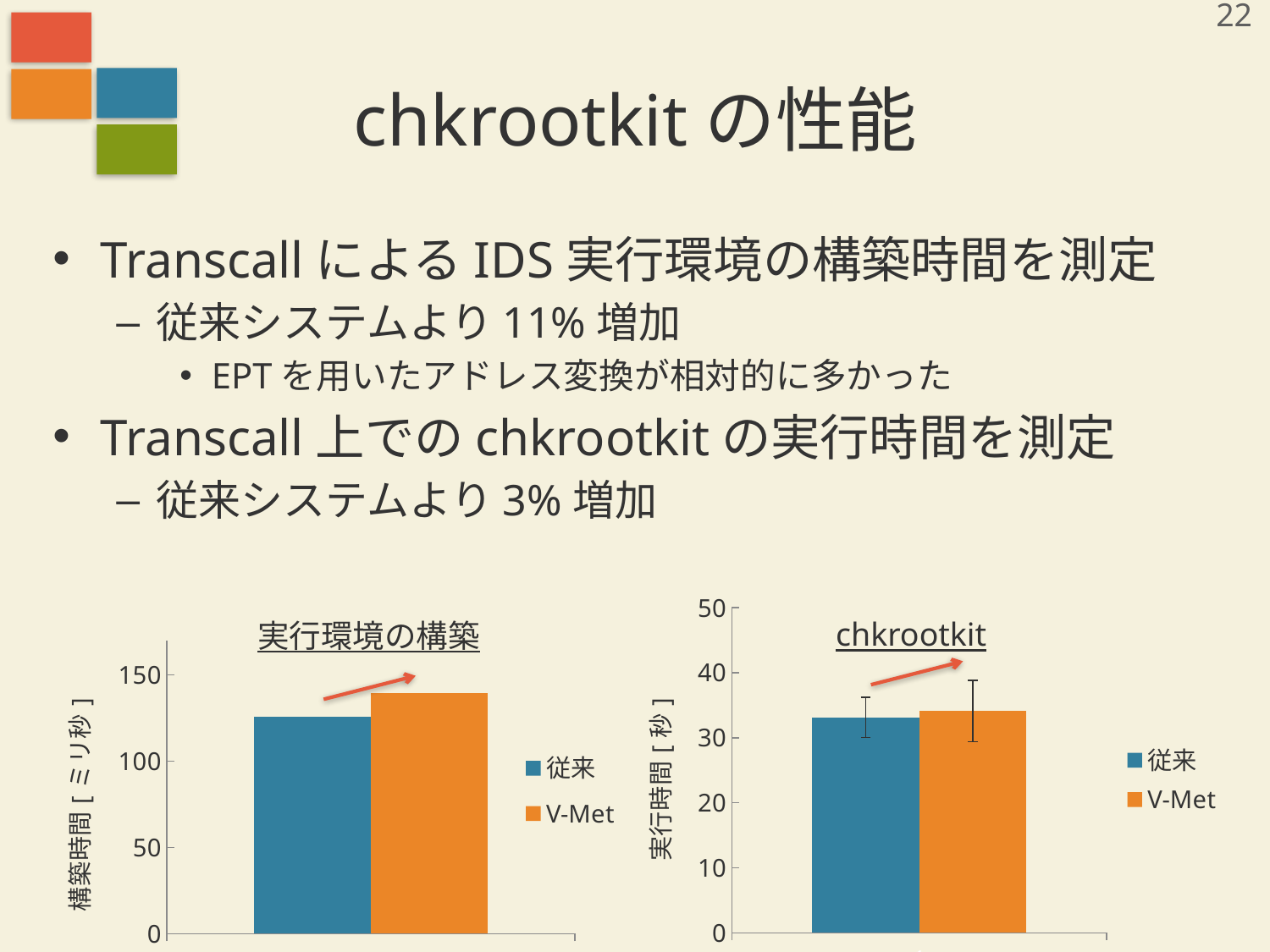
In the chart titled 実行環境の構築, which series is shown in orange? V-Met In the chart titled chkrootkit, is the value for 従来 greater or less than 30? greater In the chart titled chkrootkit, is the value for V-Met greater or less than 40? less In the chart titled 実行環境の構築, is the value for V-Met greater or less than 150? less What is the y-axis label of the chart titled 実行環境の構築? 構築時間 [ ミリ秒 ] How many series does the legend of the chart titled chkrootkit list? 2 In the chart titled 実行環境の構築, which series has the taller bar, 従来 or V-Met? V-Met What kind of chart is the chart titled 実行環境の構築? bar chart In the chart titled chkrootkit, what is the highest value shown on the y axis? 50 What is the y-axis label of the chart titled chkrootkit? 実行時間 [ 秒 ]